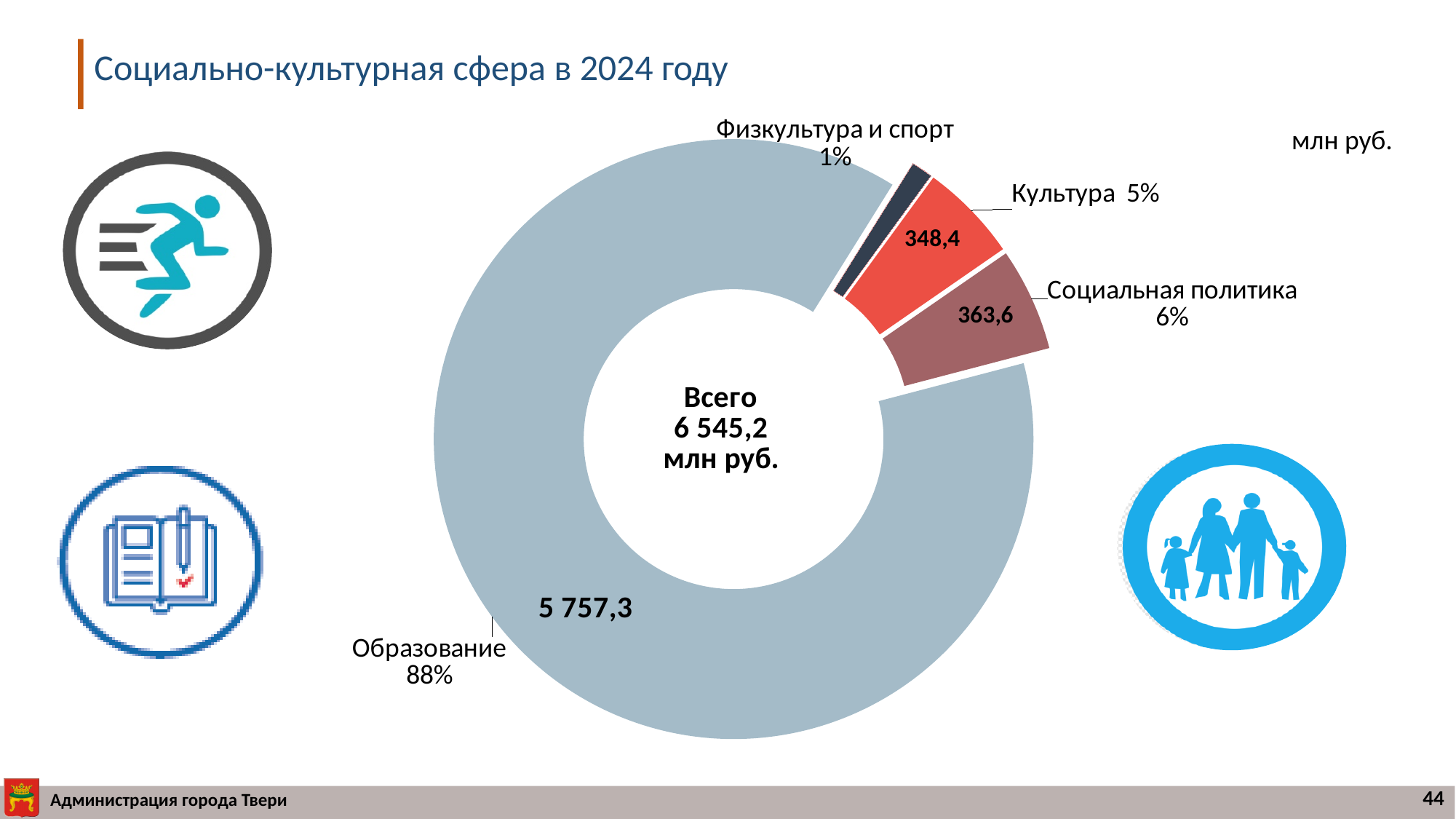
What is the difference between the values for Социальная политика and Культура? 15,2 Which is larger, the value for Культура or the value for Социальная политика? Социальная политика What share of the chart does Образование account for? 88% What is the value for Социальная политика in the chart? 363,6 What is the total (Всего) shown in the centre of the chart? 6 545,2 млн руб. What type of chart is shown on the slide? Doughnut (pie) chart Which category has the largest share of the chart? Образование What share of the chart does Социальная политика account for? 6% What is the value for Образование in the chart? 5 757,3 What is the value for Культура in the chart? 348,4 Which category has the smallest share of the chart? Физкультура и спорт How many categories are shown in the chart? 4